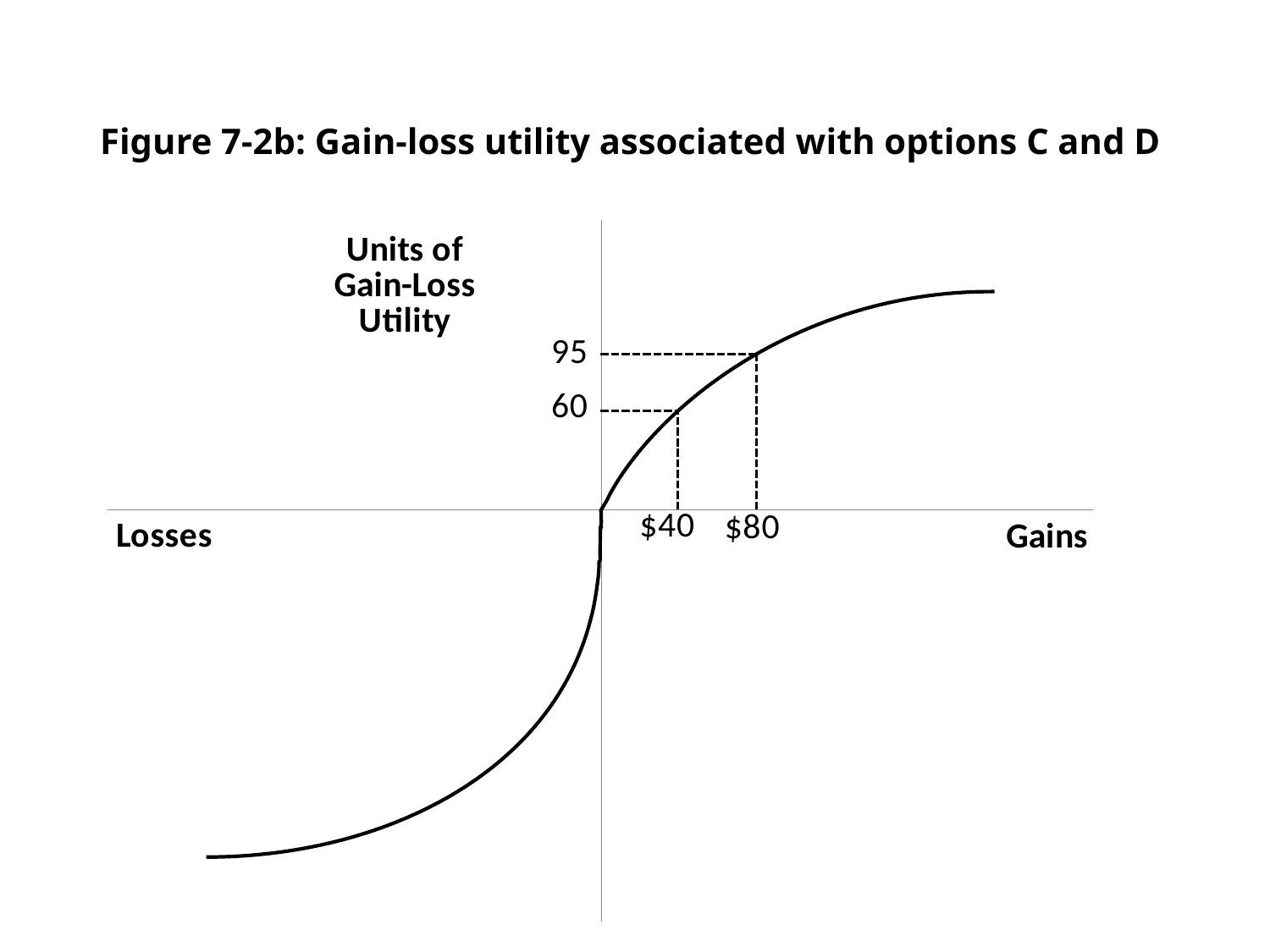
What is the label of the vertical axis? Units of Gain-Loss Utility What is the title of the chart? Figure 7-2b: Gain-loss utility associated with options C and D What kind of chart is shown on the slide? Line chart How many gain values are marked with dashed lines on the chart? 2 What is the gain-loss utility associated with a gain of $80? 95 What is the gain-loss utility associated with a gain of $40? 60 Which gain yields the higher gain-loss utility, $40 or $80? $80 What is the difference in gain-loss utility between a gain of $80 and a gain of $40? 35 Which of the two marked gains yields the lower gain-loss utility? $40 Does the gain-loss utility rise or fall as gains increase along the x axis? Rise